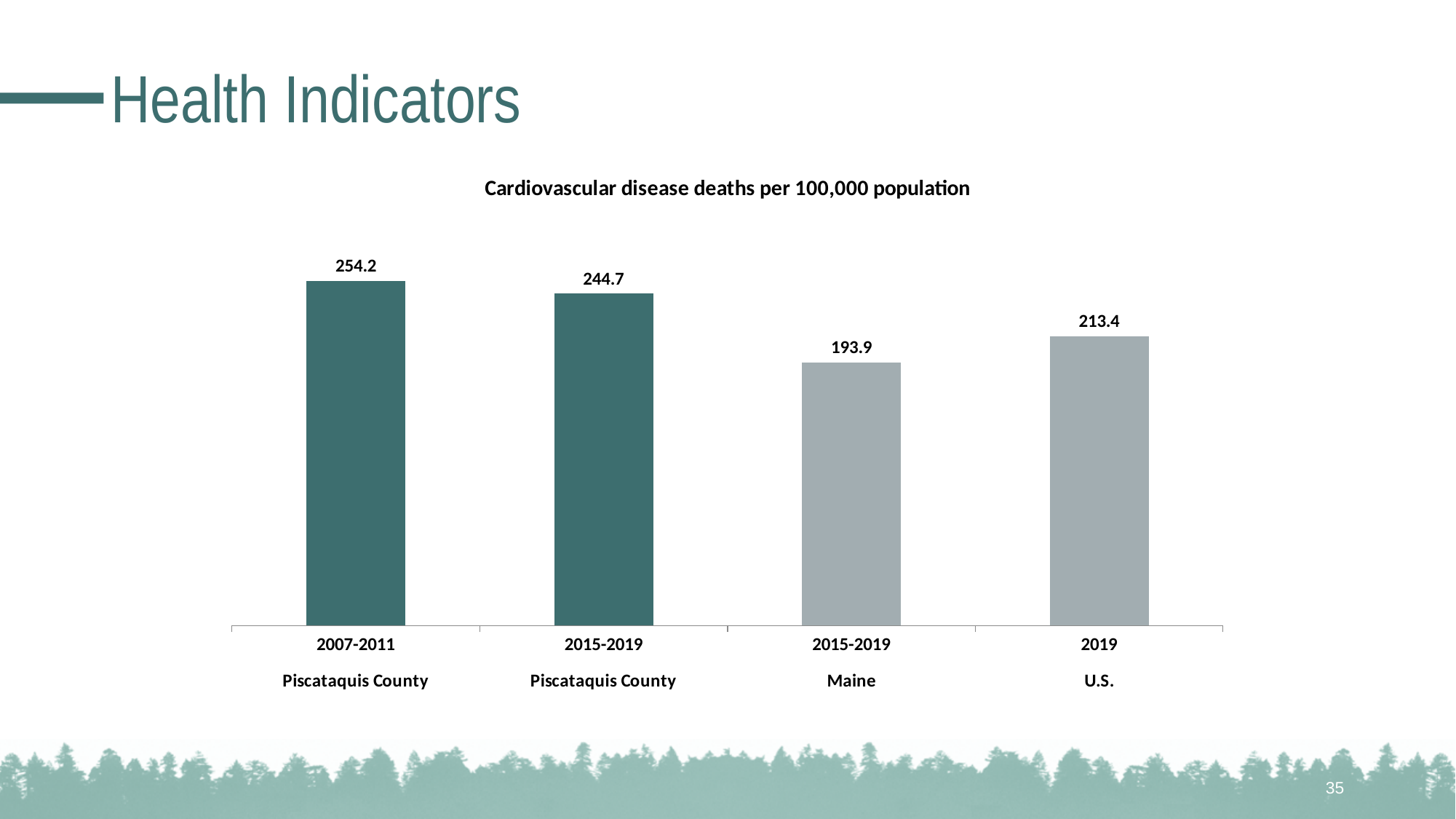
Which category has the highest cardiovascular disease death rate? Piscataquis County 2007-2011 What is the value for Piscataquis County in 2007-2011? 254.2 What kind of chart is shown on the slide? Bar chart How many bars are shown in the chart? 4 What is the value for the U.S. in 2019? 213.4 Which category has the lowest cardiovascular disease death rate? Maine 2015-2019 What is the value for Piscataquis County in 2015-2019? 244.7 Which is larger, the U.S. 2019 value or the Maine 2015-2019 value? U.S. 2019 What is the difference between the Piscataquis County 2015-2019 value and the Maine 2015-2019 value? 50.8 What is the title of the chart? Cardiovascular disease deaths per 100,000 population What is the difference between the Piscataquis County 2007-2011 value and the Piscataquis County 2015-2019 value? 9.5 What is the value for Maine in 2015-2019? 193.9